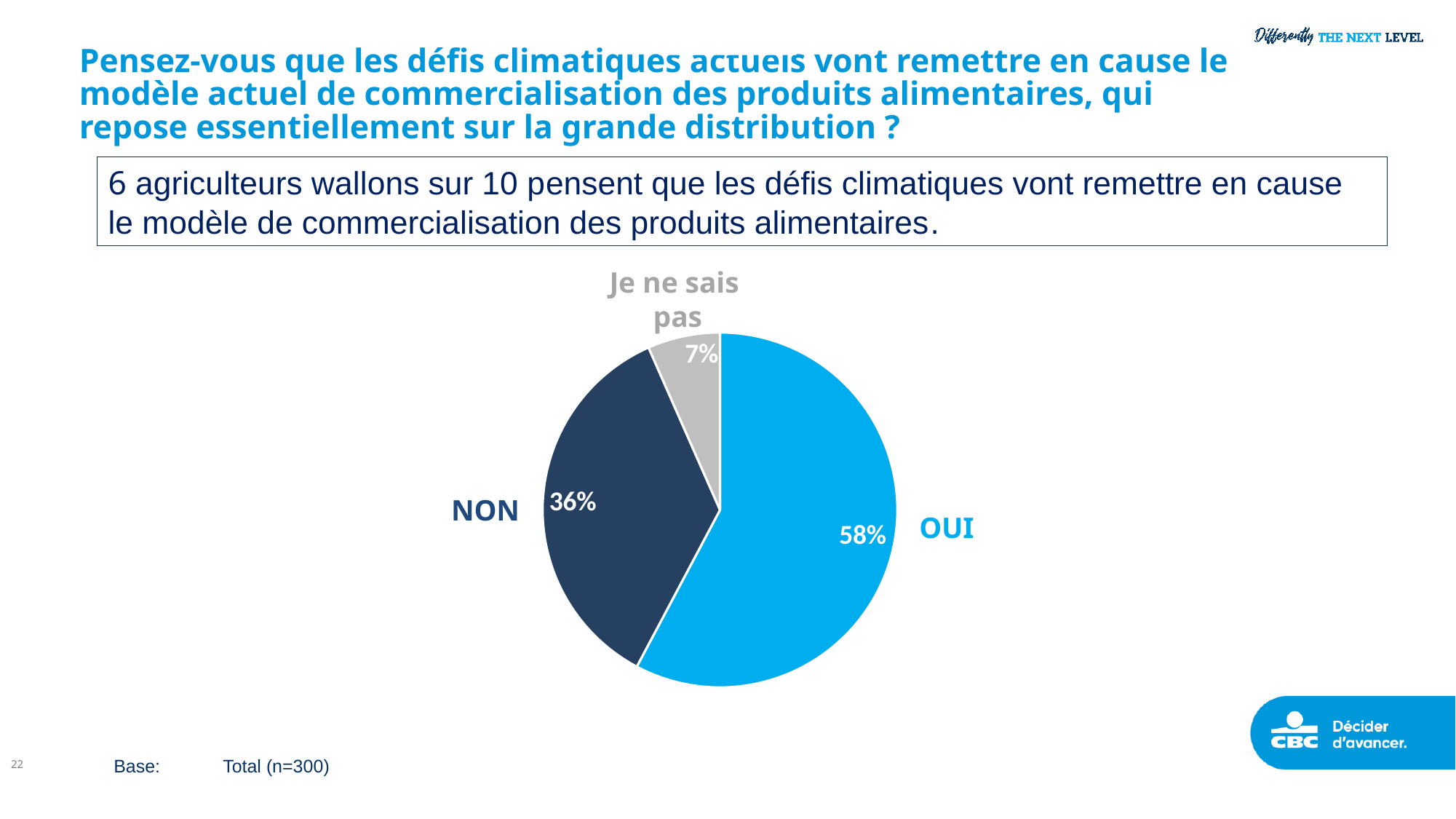
What percentage of respondents answered 'Je ne sais pas'? 7% What is the difference in percentage points between NON and 'Je ne sais pas'? 29 Which is larger, the share for NON or the share for 'Je ne sais pas'? NON What colour is the OUI slice? Light blue What percentage of respondents answered OUI? 58% Which response has the largest share of the pie? OUI What is the difference in percentage points between OUI and NON? 22 Which response has the smallest share of the pie? Je ne sais pas What is the base (sample size) stated for the chart? Total (n=300) What percentage of respondents answered NON? 36% How many slices does the pie chart have? 3 What kind of chart is shown on the slide? Pie chart